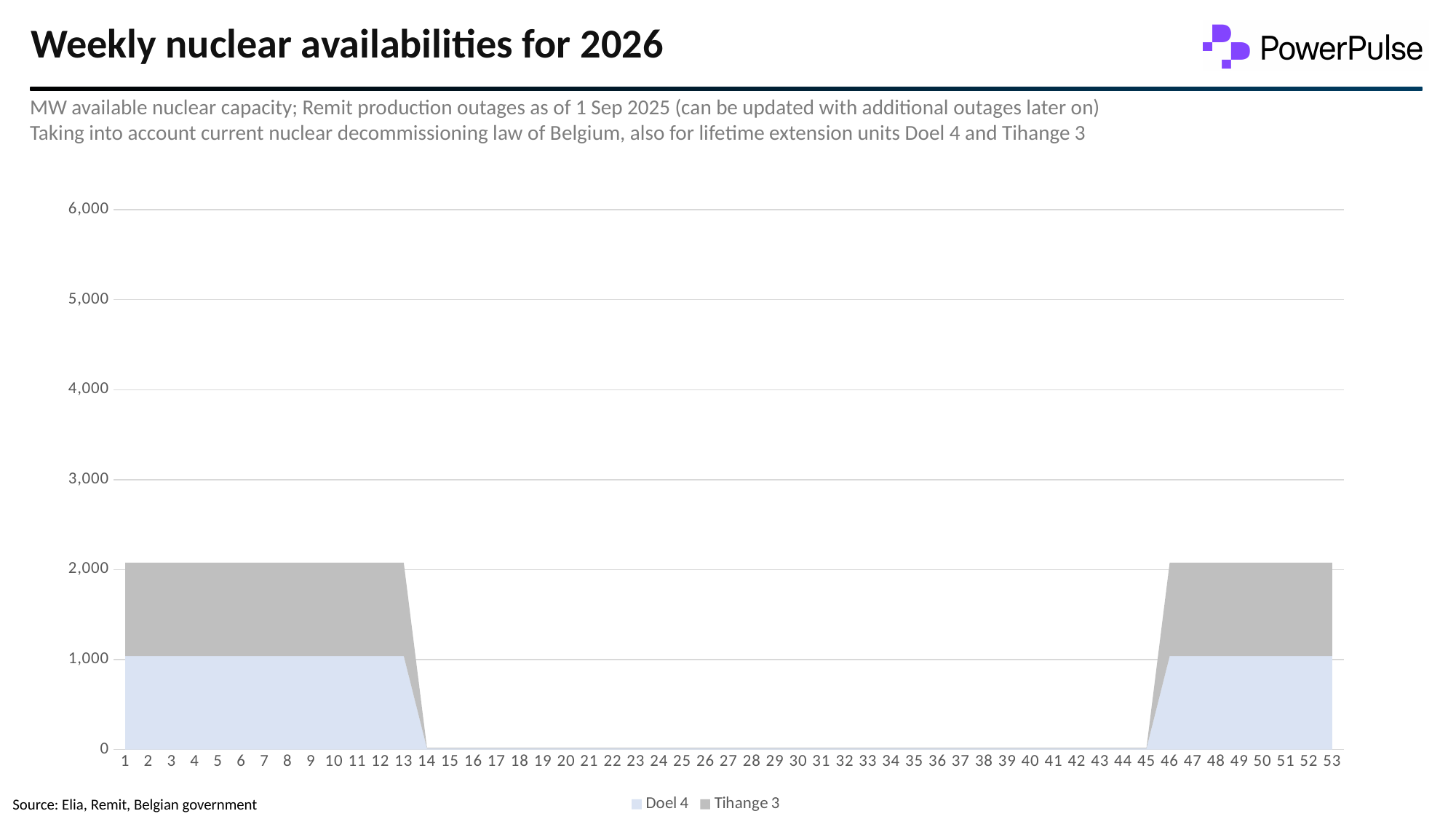
Is the total stacked value in week 50 greater or less than 1,000? greater Is the value for Doel 4 in week 5 greater or less than 2,000? less Is the total stacked value in week 5 greater or less than 3,000? less Which two series are listed in the legend? Doel 4 and Tihange 3 What is the title of the chart? Weekly nuclear availabilities for 2026 How many weeks are shown on the x axis? 53 Do the values rise or fall between week 13 and week 14? fall What kind of chart is shown on the slide? area chart How many series does the legend list? 2 Do the values rise or fall between week 45 and week 46? rise